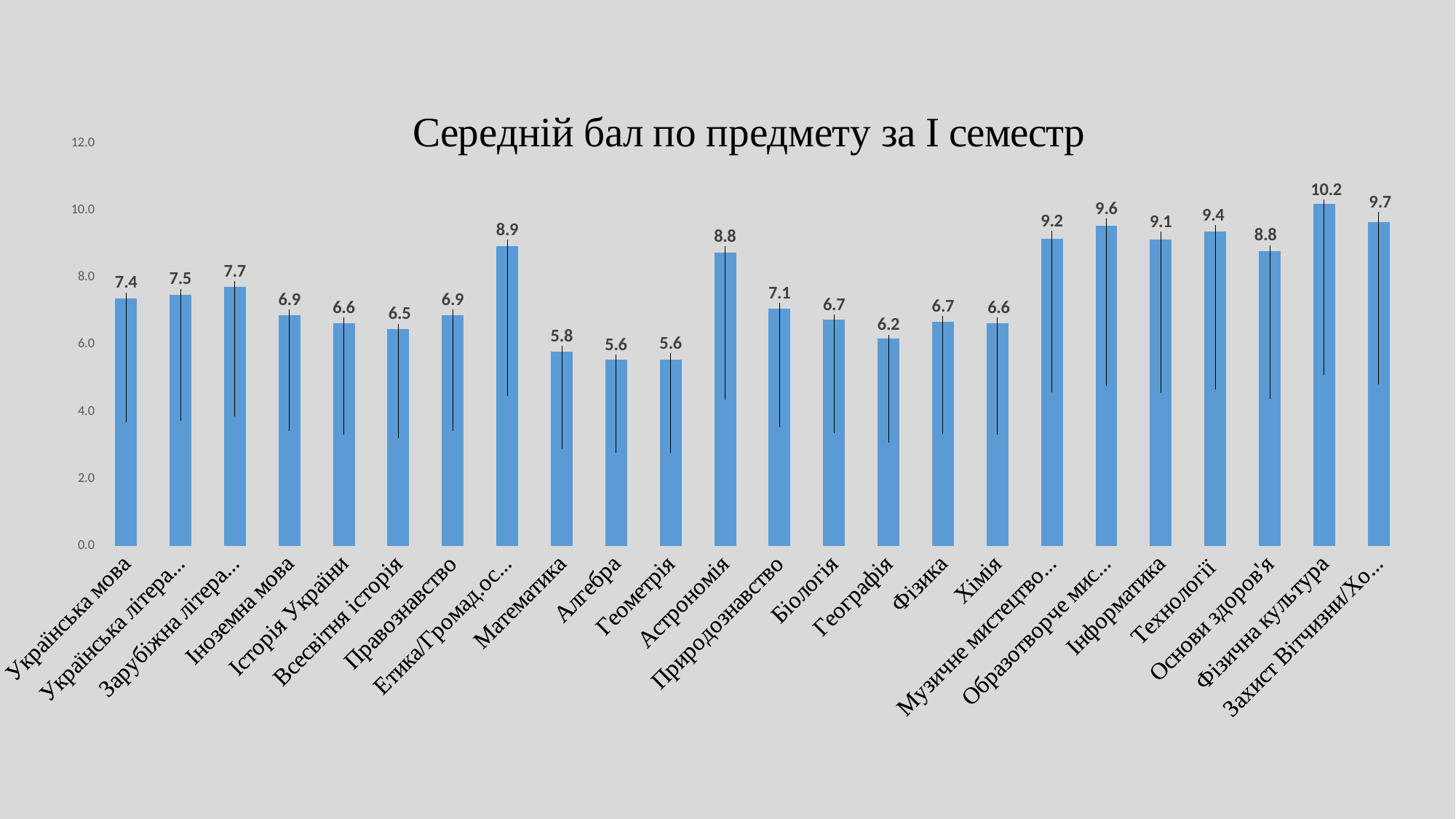
Which has a higher value, Технології or Основи здоров'я? Технології What is the value shown for Інформатика? 9.1 What is the title of the chart? Середній бал по предмету за І семестр What is the average score for Фізична культура? 10.2 What kind of chart is shown on the slide? Bar chart How many subjects are shown on the chart? 24 Which subject has the highest average score? Фізична культура Is the value for Образотворче мис... greater or less than 8.0? greater What is the value shown for Географія? 6.2 What is the difference between the values for Фізична культура and Математика? 4.4 What is the value shown for Астрономія? 8.8 What is the lowest value shown on the chart? 5.6